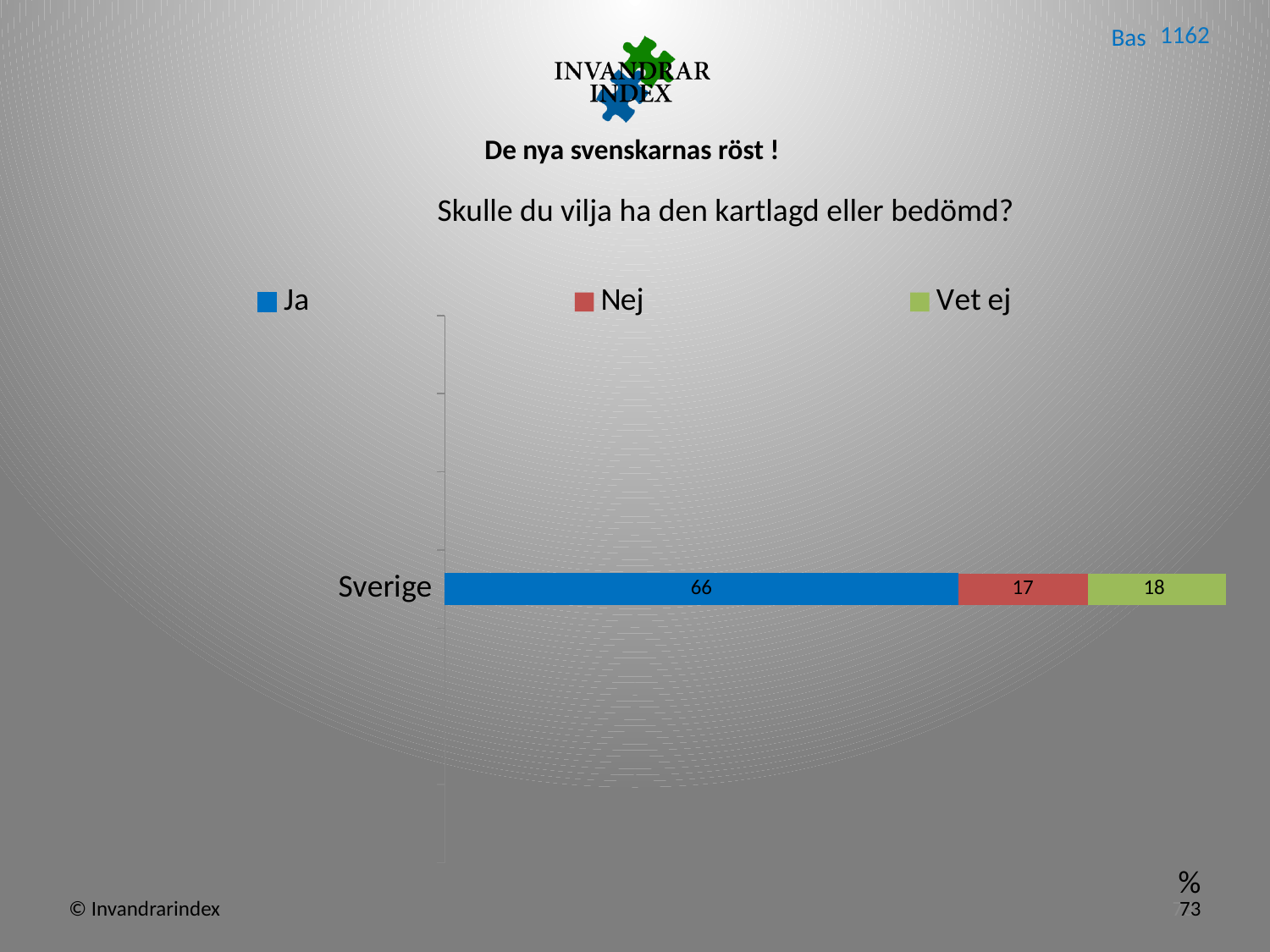
How many categories are plotted on the chart? 1 What is the value for Ja for Sverige? 66 Which series has the lowest value for Sverige? Nej What kind of chart is shown on the slide? Stacked bar chart Which series has the highest value for Sverige? Ja What is the difference between the Vet ej and Nej values for Sverige? 1 What is the difference between the Ja and Nej values for Sverige? 49 Which is larger for Sverige, Ja or Vet ej? Ja What is the value for Vet ej for Sverige? 18 How many series does the legend list? 3 What is the value for Nej for Sverige? 17 What is the total of the stacked bar for Sverige? 101